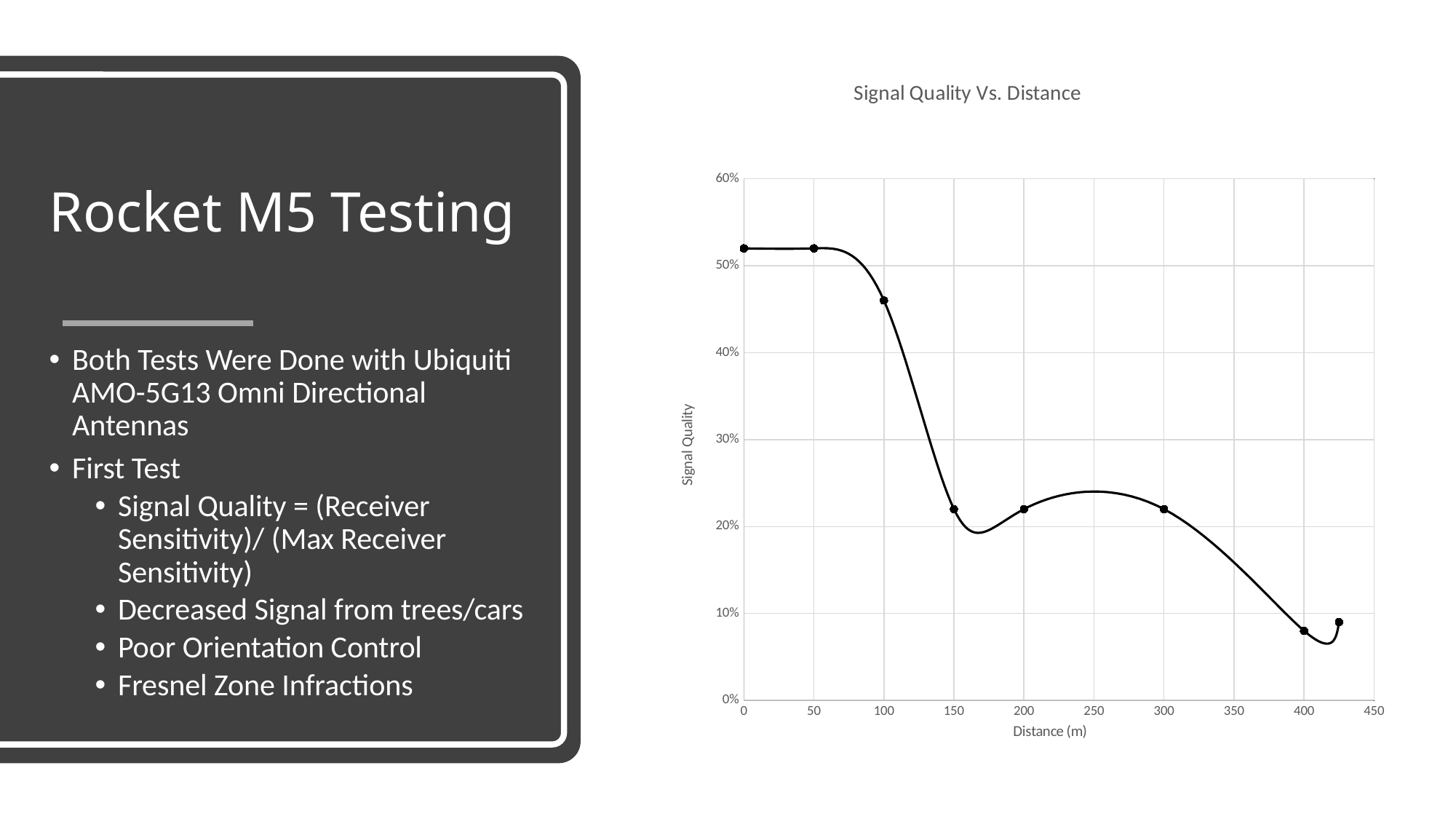
What is the title of the chart? Signal Quality Vs. Distance Is the signal quality at a distance of 400 m greater or less than 10%? less What kind of chart is shown on the slide? line chart How many data points are plotted on the chart? 8 Which has the higher signal quality: the point at 100 m or the point at 200 m? 100 m Is the signal quality at a distance of 150 m greater or less than 30%? less Is the signal quality at a distance of 200 m greater or less than 30%? less Which has the higher signal quality: the point at 50 m or the point at 400 m? 50 m Overall, does signal quality rise or fall as distance increases along the x axis? fall What is the label of the x axis of the chart? Distance (m)